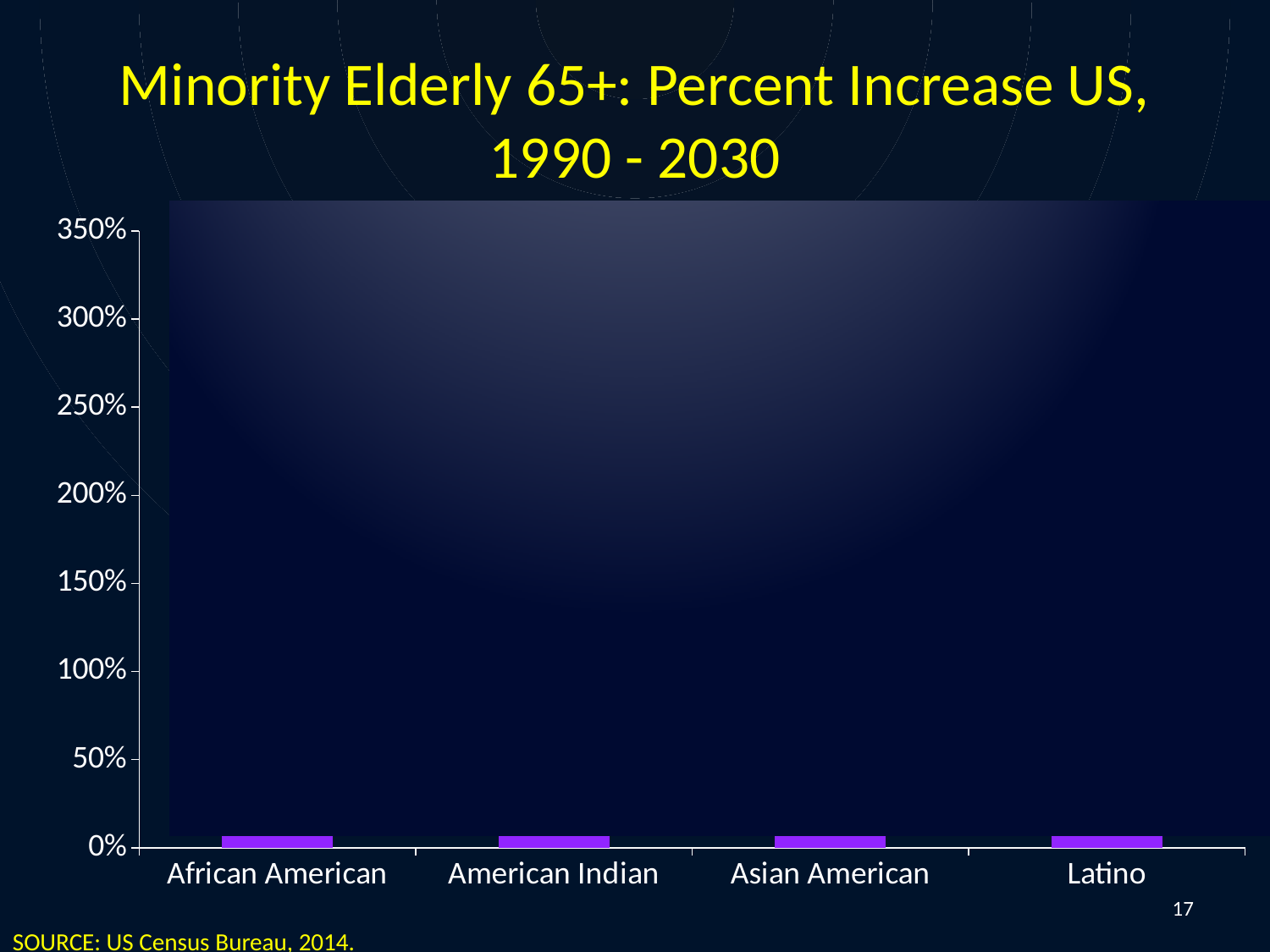
What kind of chart is shown on the slide? bar chart Which category is listed last on the x axis of the chart? Latino What is the title of the chart? Minority Elderly 65+: Percent Increase US, 1990 - 2030 What is the highest value shown on the y axis of the chart? 350% Which category is listed first on the x axis of the chart? African American How many categories are shown on the x axis of the chart? 4